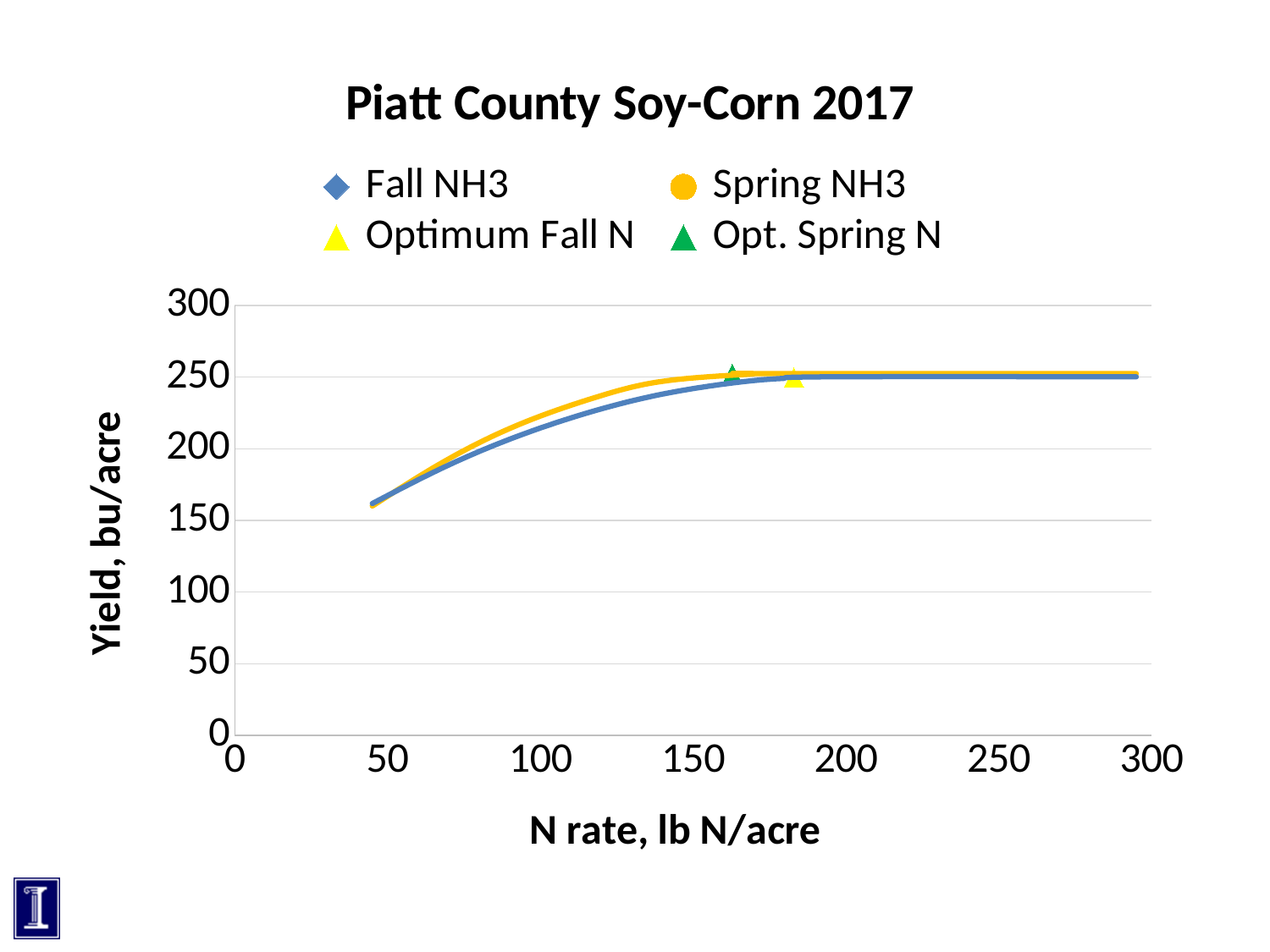
Is the Spring NH3 yield at an N rate of 300 lb N/acre greater or less than 200 bu/acre? greater Which marker is at a higher N rate, Optimum Fall N or Opt. Spring N? Optimum Fall N Does the Spring NH3 yield rise or fall as the N rate increases from 50 to 150 lb N/acre? rise Is the Fall NH3 yield at an N rate of 50 lb N/acre greater or less than 200 bu/acre? less At an N rate of 100 lb N/acre, which series has the higher yield, Fall NH3 or Spring NH3? Spring NH3 Is the Fall NH3 yield at an N rate of 100 lb N/acre greater or less than 250 bu/acre? less How many series does the chart legend list? 4 What kind of chart is shown on the slide? line chart What is the label of the y axis? Yield, bu/acre What is the title of the chart? Piatt County Soy-Corn 2017